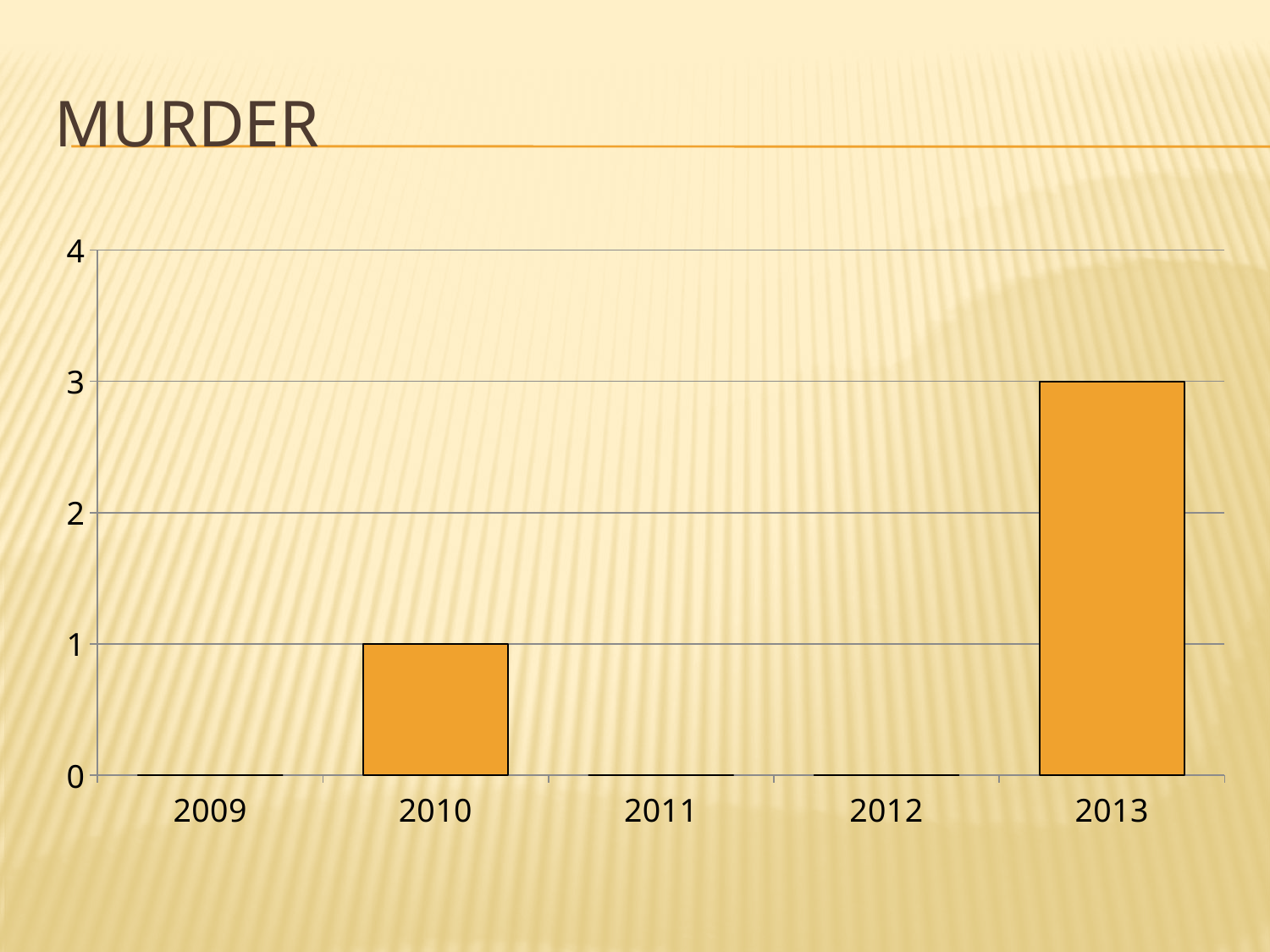
What is the highest value shown on the y axis? 4 What is the value for 2009? 0 What is the value for 2013? 3 Which is larger, the value for 2010 or the value for 2013? 2013 What kind of chart is shown on the slide? bar chart What is the value for 2010? 1 What is the difference between the values for 2013 and 2010? 2 How many years are shown on the x axis? 5 What is the title of the slide? MURDER Is the value for 2013 greater or less than 2? greater How many years have a value of 0? 3 Which year has the highest value? 2013